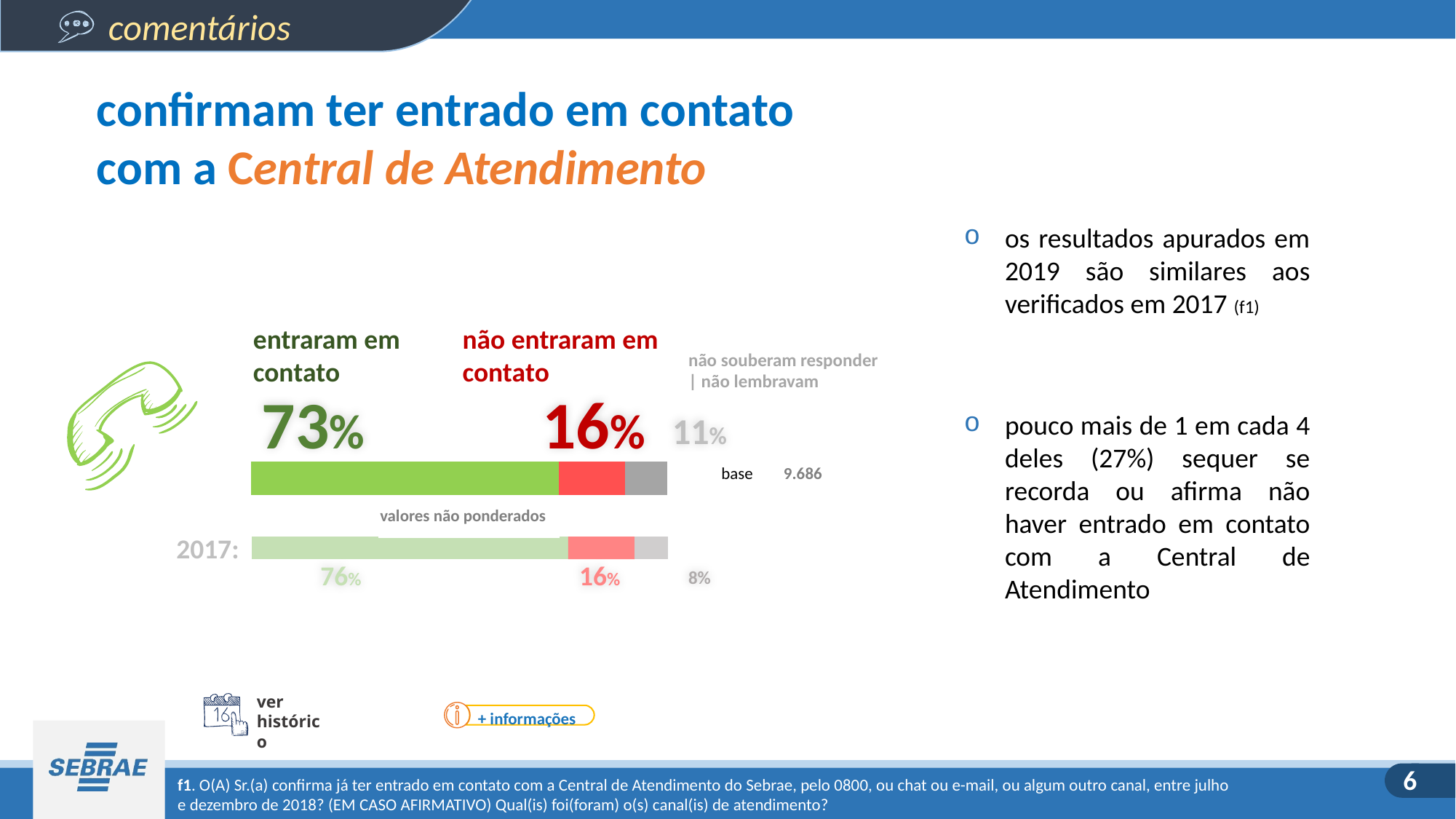
How many segments does each bar in the chart have? 3 Which segment is the smallest in the 2017 bar? não souberam responder | não lembravam In the 2017 bar, what percentage had contacted the Central de Atendimento? 76% What percentage of respondents confirmed having contacted the Central de Atendimento in the current (2019) bar? 73% What percentage of respondents did not contact the Central de Atendimento in the current (2019) bar? 16% In the 2017 bar, what percentage did not know or did not remember? 8% What is the base (number of respondents) shown for the chart? 9.686 What type of chart is used to show the contact results? stacked bar chart What percentage of respondents did not know or did not remember in the current (2019) bar? 11% Which segment is the largest in the current (2019) bar? entraram em contato Is the 'não souberam responder | não lembravam' share larger in 2019 or in 2017? 2019 What is the difference between the 'entraram em contato' share in 2017 and in 2019? 3 percentage points